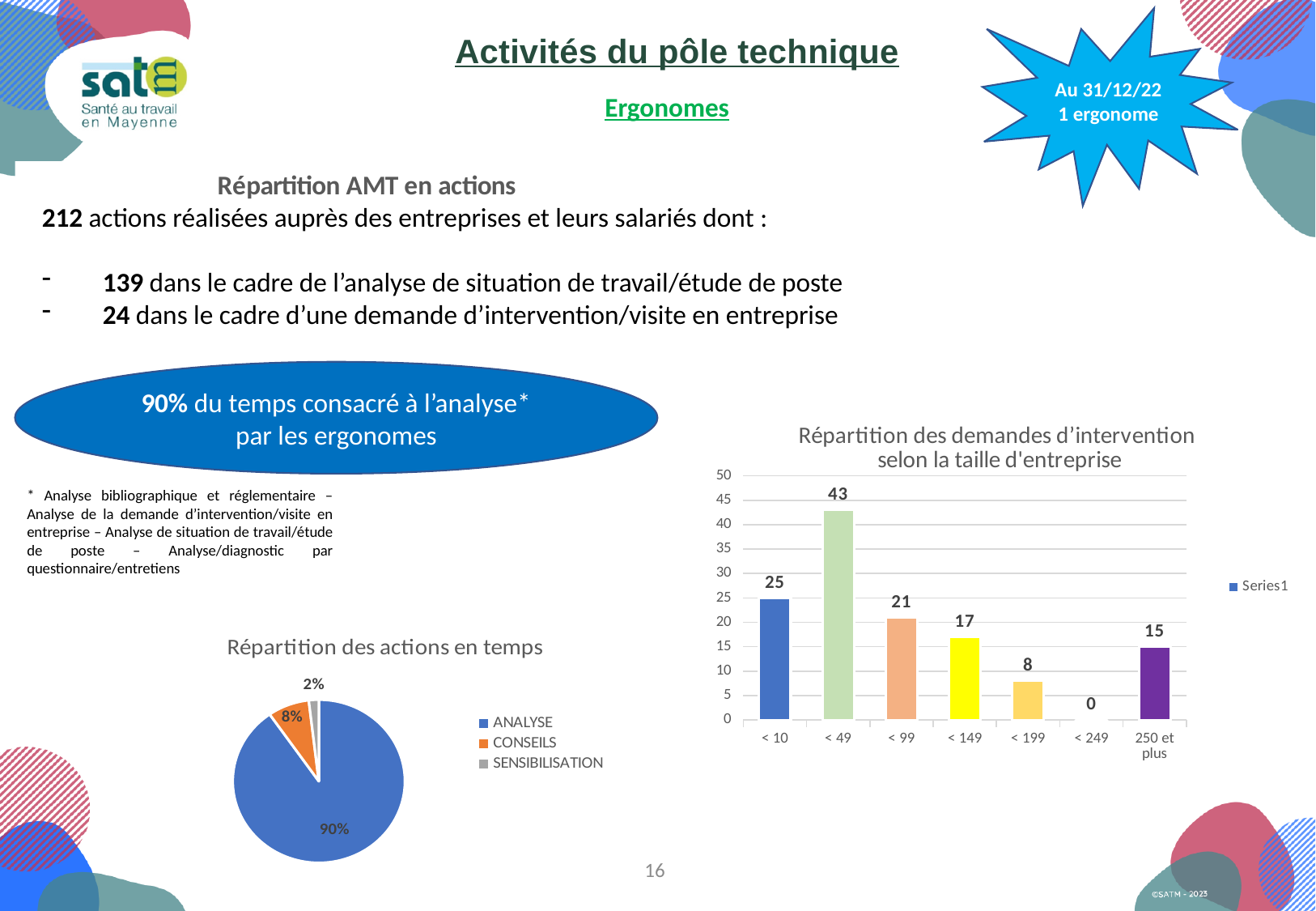
In the chart 'Répartition des demandes d'intervention selon la taille d'entreprise', what is the difference between the values for '< 10' and '< 99'? 4 How many categories are shown on the x axis of the chart 'Répartition des demandes d'intervention selon la taille d'entreprise'? 7 In the chart 'Répartition des demandes d'intervention selon la taille d'entreprise', which category has the highest value? < 49 In the pie chart 'Répartition des actions en temps', which category has the smallest slice? SENSIBILISATION In the chart 'Répartition des demandes d'intervention selon la taille d'entreprise', what is the value for '< 49'? 43 What kind of chart is 'Répartition des demandes d'intervention selon la taille d'entreprise'? Bar chart In the pie chart 'Répartition des actions en temps', what share does ANALYSE have? 90% In the chart 'Répartition des demandes d'intervention selon la taille d'entreprise', which is larger, the value for '< 149' or the value for '< 199'? < 149 In the pie chart 'Répartition des actions en temps', what share does CONSEILS have? 8% In the chart 'Répartition des demandes d'intervention selon la taille d'entreprise', which category has the lowest value? < 249 In the chart 'Répartition des demandes d'intervention selon la taille d'entreprise', what is the value for '250 et plus'? 15 How many entries does the legend of the pie chart 'Répartition des actions en temps' list? 3